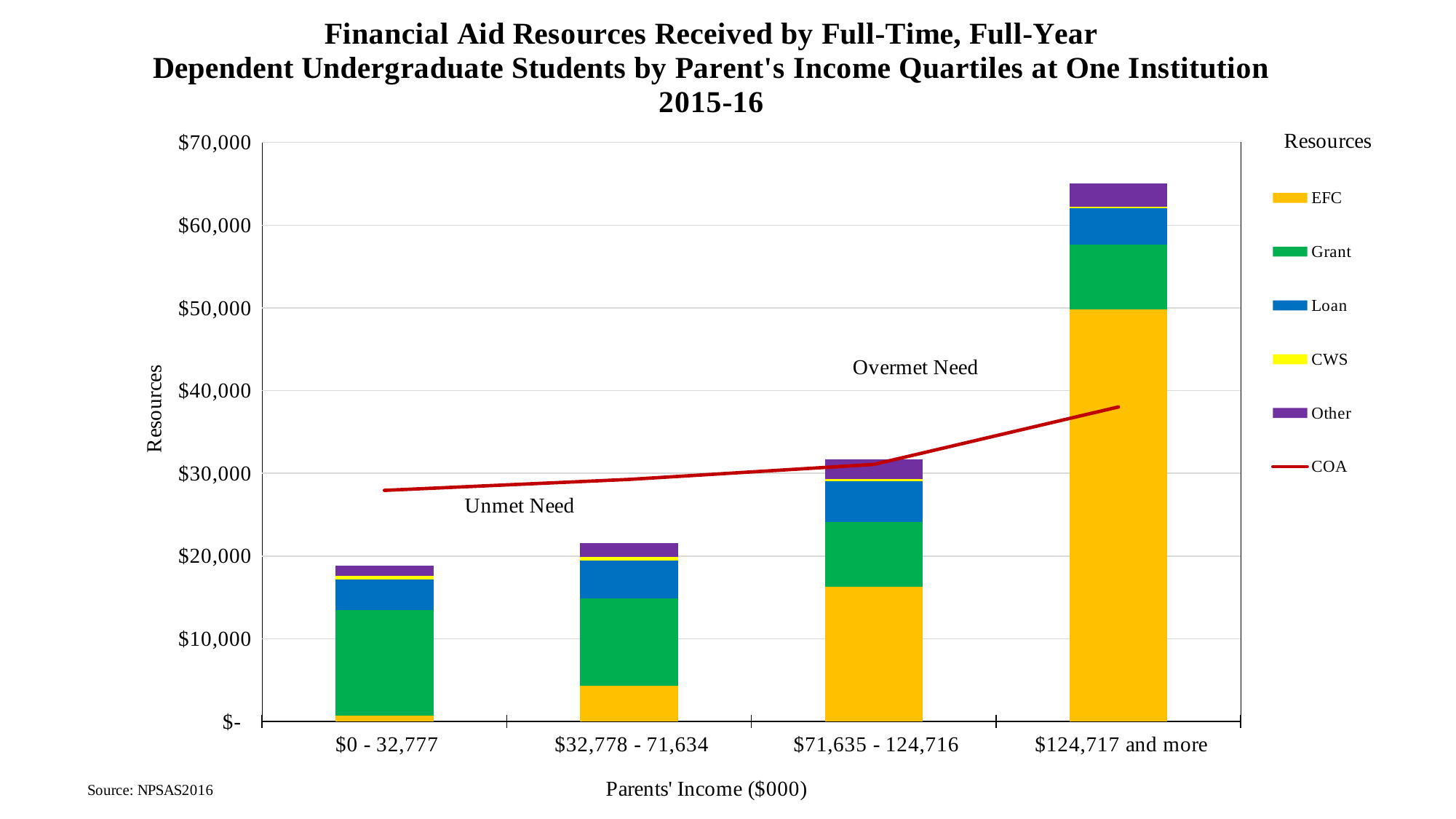
Is the total stacked bar for $0 - 32,777 greater or less than $20,000? less How many parents' income quartile categories are shown on the x axis? 4 How many series does the legend list? 6 Which quartile has the larger EFC segment: $71,635 - 124,716 or $124,717 and more? $124,717 and more Is the COA value for $0 - 32,777 greater or less than $30,000? less Which income quartile has the highest total stacked bar? $124,717 and more Is the total stacked bar for $124,717 and more greater or less than $60,000? greater Which income quartile has the lowest total stacked bar? $0 - 32,777 What kind of chart is shown on the slide? Stacked bar chart with a line Does the COA line rise or fall as parents' income increases along the x axis? rises What is the title of the x axis? Parents' Income ($000)